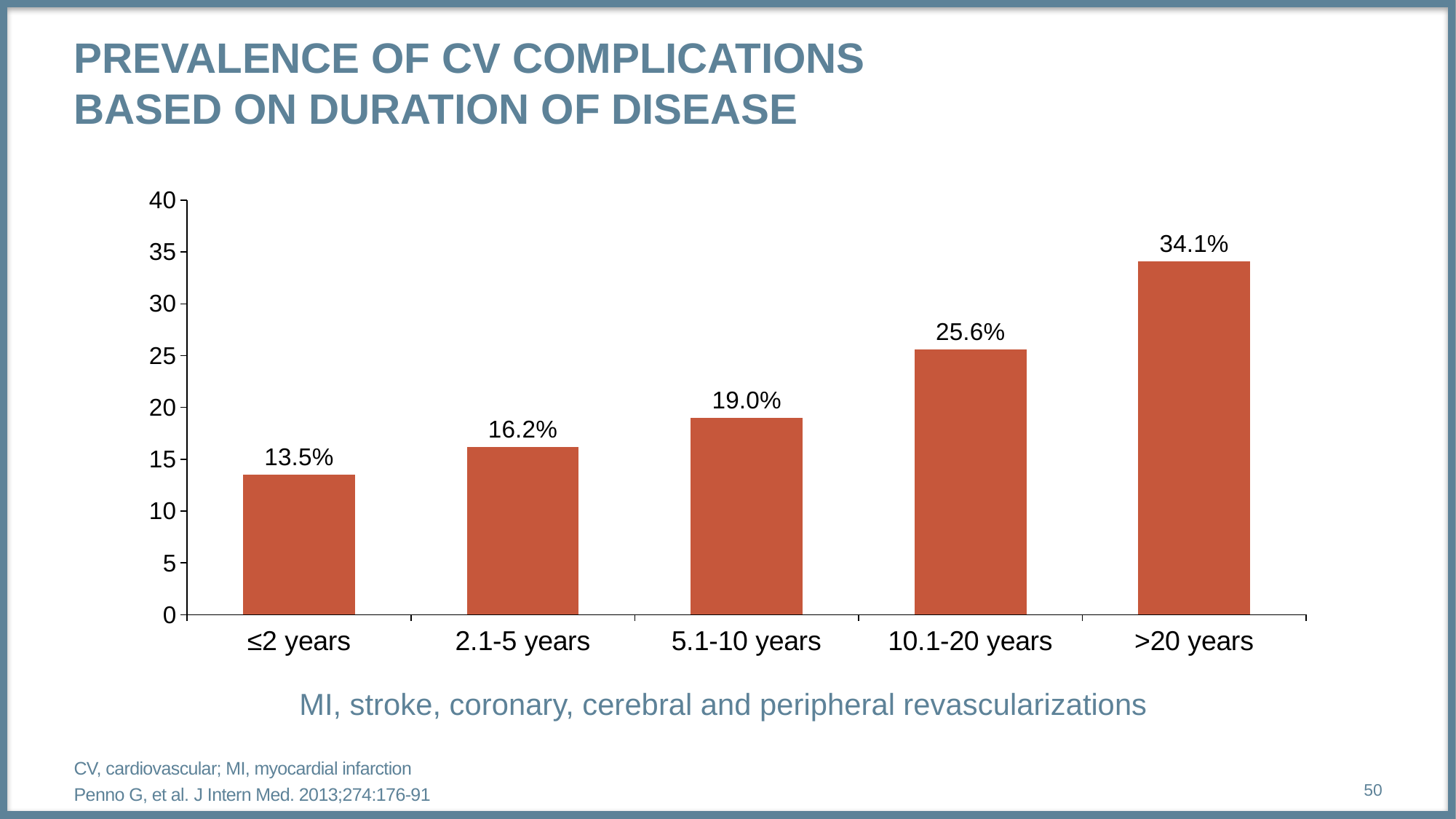
How many duration categories are shown on the chart? 5 Is the value for the 10.1-20 years group greater or less than 25? greater Do the prevalence values rise or fall as the duration of disease increases along the x axis? Rise What is the prevalence of CV complications for the ≤2 years duration group? 13.5% What is the difference in prevalence between the >20 years group and the 10.1-20 years group? 8.5% What is the prevalence of CV complications for the >20 years duration group? 34.1% Which duration group has the lowest prevalence of CV complications? ≤2 years Which duration group has the highest prevalence of CV complications? >20 years What is the difference in prevalence between the 2.1-5 years group and the ≤2 years group? 2.7% What kind of chart is shown on the slide? Bar chart What is the prevalence of CV complications for the 5.1-10 years duration group? 19.0% Which has a higher prevalence of CV complications: the 5.1-10 years group or the 10.1-20 years group? 10.1-20 years